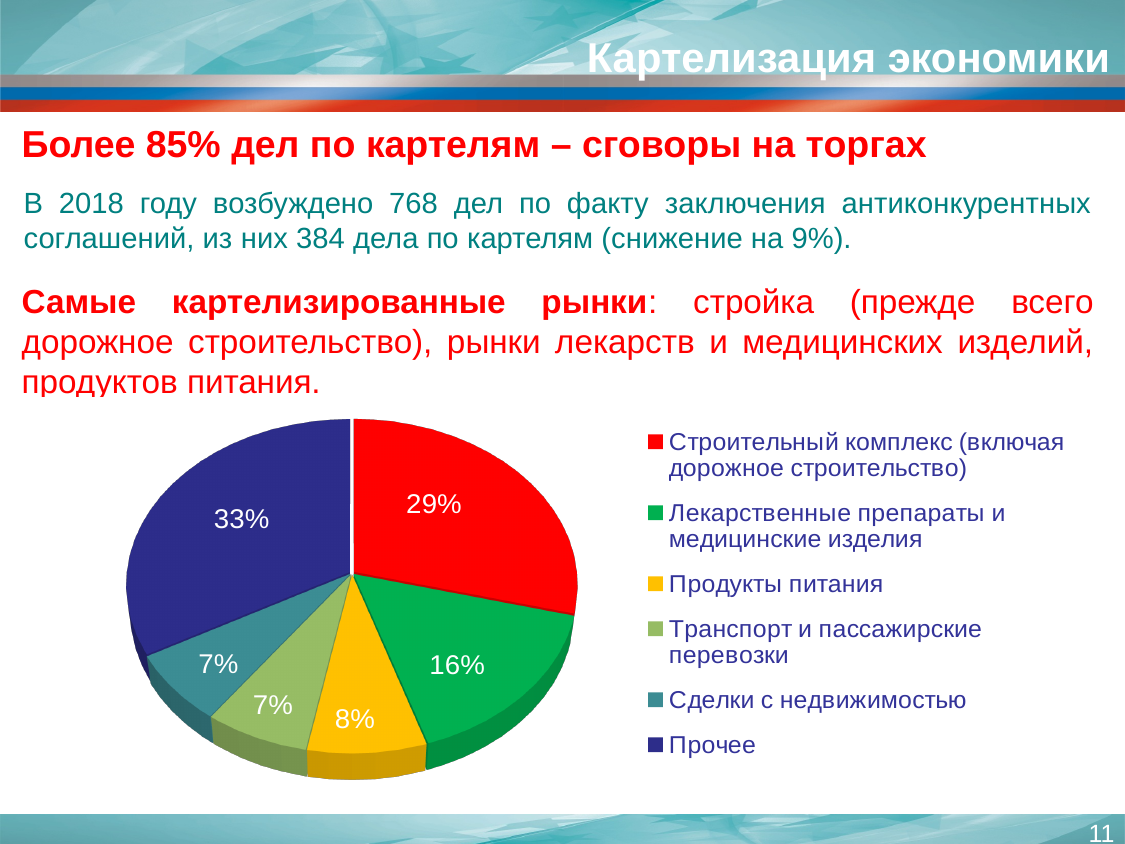
What value is shown for Сделки с недвижимостью? 7% What percentage is shown for Лекарственные препараты и медицинские изделия? 16% What is the combined share of Транспорт и пассажирские перевозки and Сделки с недвижимостью? 14% What type of chart is shown on the slide? Pie chart What value is labelled on the Продукты питания slice? 8% How many slices does the pie chart have? 6 What share of the pie does the slice for Строительный комплекс (включая дорожное строительство) represent? 29% What percentage does the Прочее slice show? 33% Which category has the largest slice of the pie? Прочее What is the difference in percentage points between the Прочее slice and the Строительный комплекс slice? 4 Which is larger: the slice for Лекарственные препараты и медицинские изделия or the slice for Продукты питания? Лекарственные препараты и медицинские изделия What colour is the slice for Продукты питания? Yellow